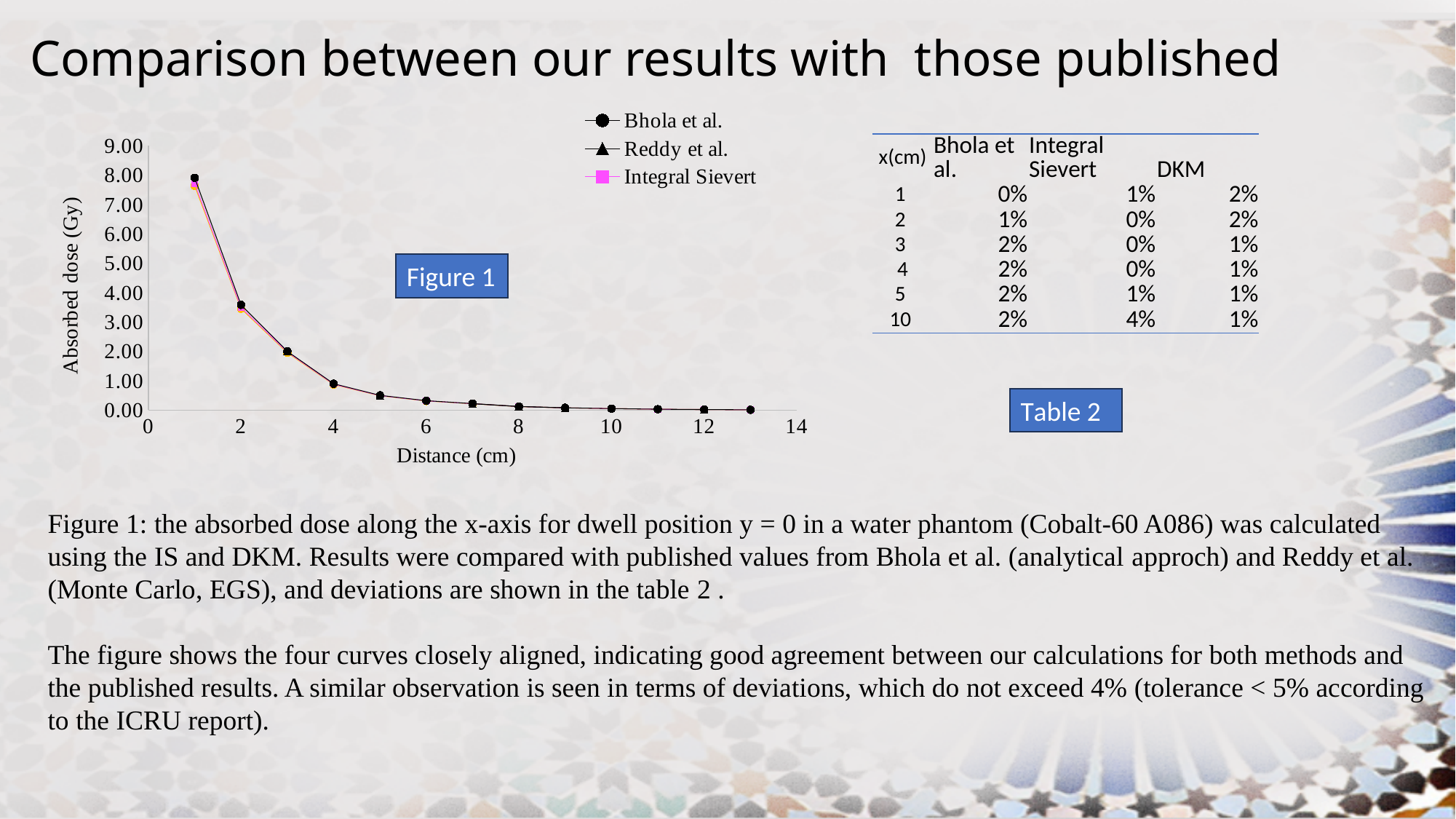
In Figure 1, how many series does the legend list? 3 In Figure 1, how many data points are plotted for the Bhola et al. series? 13 In Figure 1, is the absorbed dose for Bhola et al. at a distance of 6 cm greater or less than 1.00 Gy? less In Figure 1, is the absorbed dose for Bhola et al. at a distance of 2 cm greater or less than 4.00 Gy? less In Figure 1, is the absorbed dose for Bhola et al. at a distance of 1 cm greater or less than 7.00 Gy? greater In Figure 1, which is larger: the absorbed dose at 1 cm or at 4 cm? 1 cm In Figure 1, at which distance is the absorbed dose highest? 1 cm What kind of chart is Figure 1? line chart What is the label of the vertical axis in Figure 1? Absorbed dose (Gy) In Figure 1, do the absorbed dose values rise or fall as distance increases? fall What is the label of the horizontal axis in Figure 1? Distance (cm)